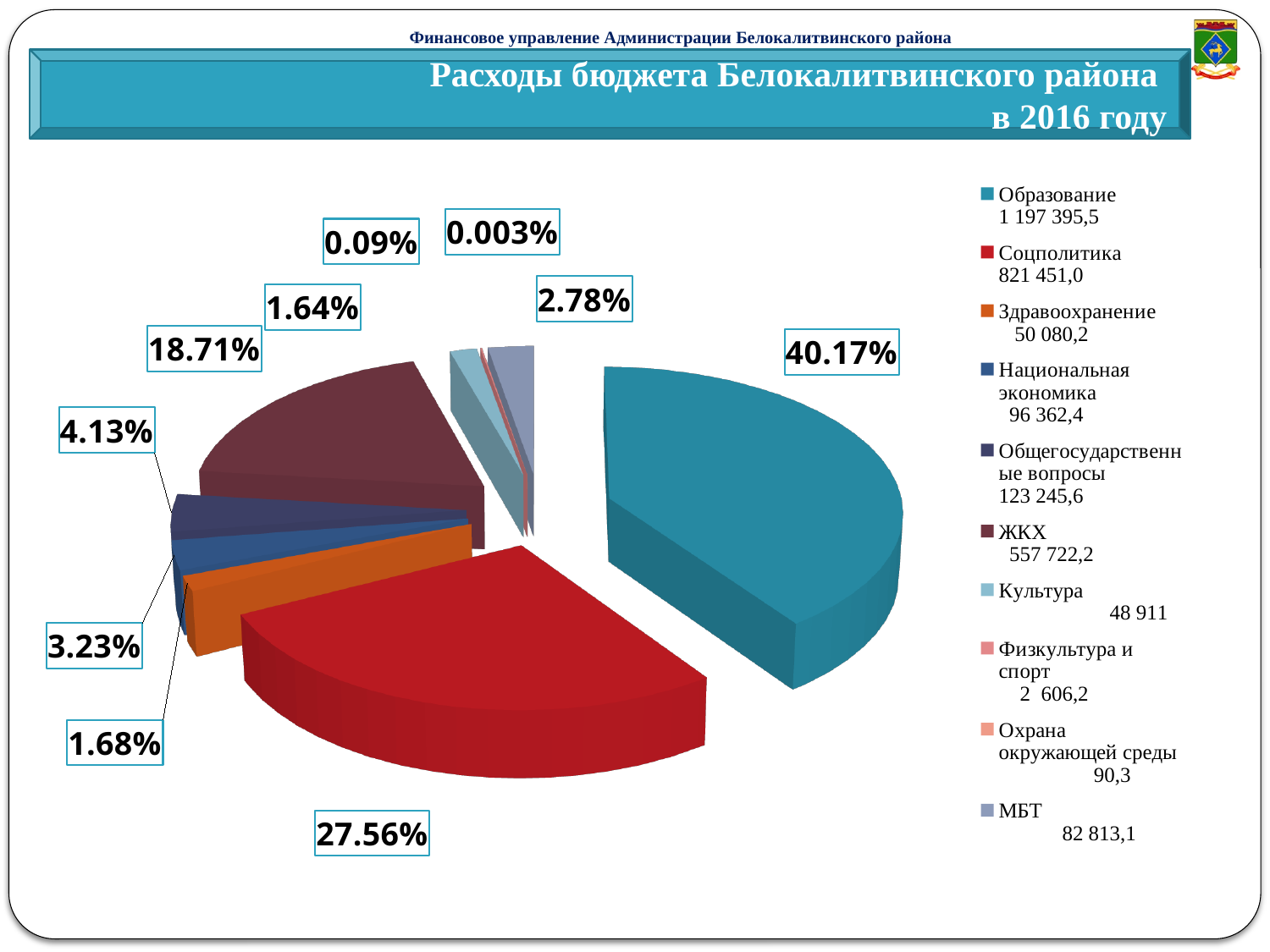
What value is shown in the legend for Здравоохранение? 50 080,2 What value is shown in the legend for МБТ? 82 813,1 What share of the pie does Образование account for? 40.17% Which category has the smallest share of the pie chart? Охрана окружающей среды How many categories does the legend of the pie chart list? 10 What share of the pie does Соцполитика account for? 27.56% Which is larger, the share for Общегосударственные вопросы or the share for Национальная экономика? Общегосударственные вопросы What kind of chart is shown on the slide? pie chart What is the difference in percentage points between the shares of Образование and Соцполитика? 12.61 What value is shown in the legend for Национальная экономика? 96 362,4 What share of the pie does ЖКХ account for? 18.71% Which category has the largest share of the pie chart? Образование